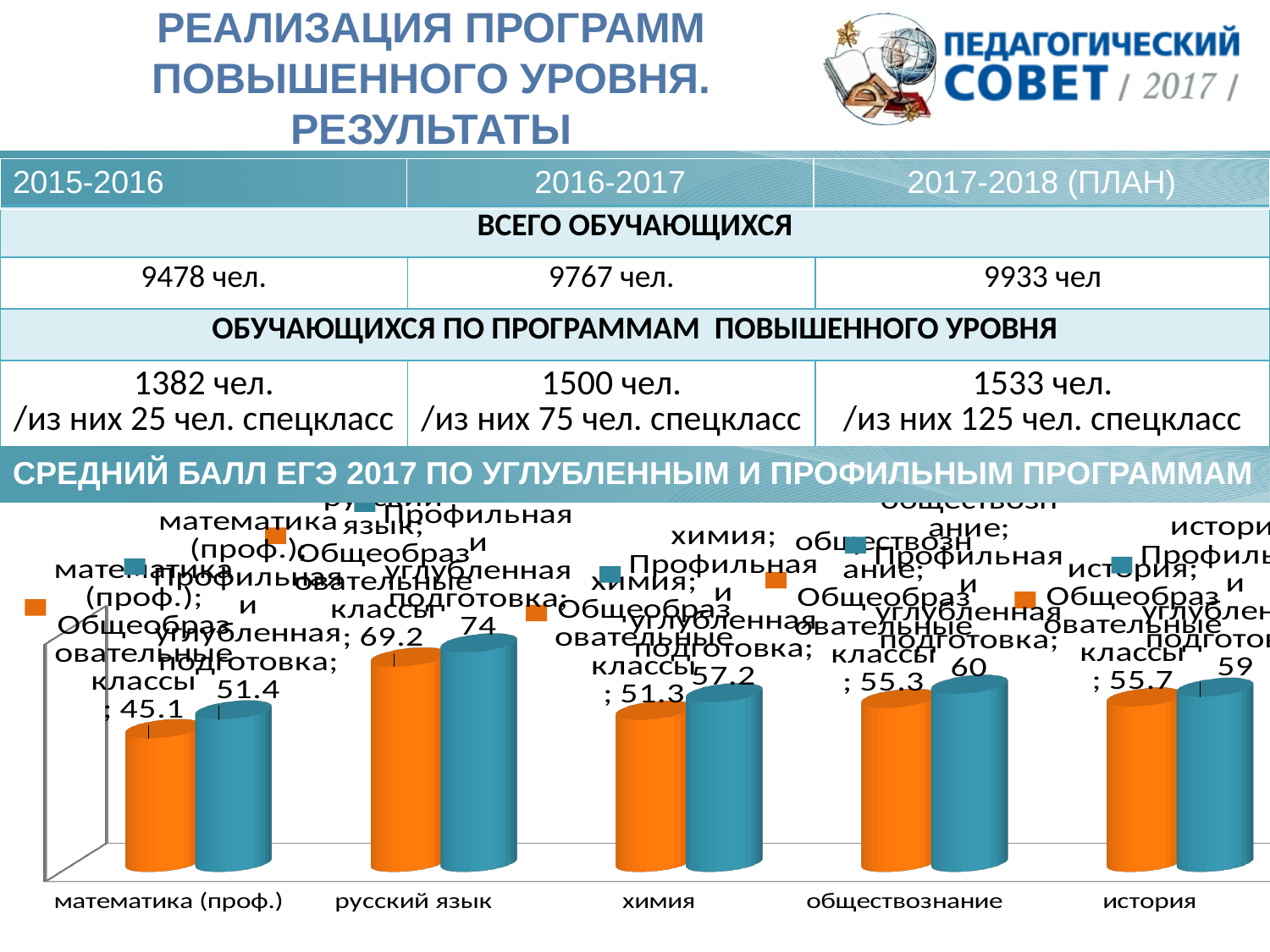
Which subject has the highest value for Профильная и углубленная подготовка? русский язык Which subject has the lowest value for Общеобразовательные классы? математика (проф.) How many series does the chart show? 2 How many subjects are shown on the x axis of the chart? 5 What is the difference between Профильная и углубленная подготовка and Общеобразовательные классы in математика (проф.)? 6.3 What is the value for Профильная и углубленная подготовка in обществознание? 60 What is the value for Общеобразовательные классы in математика (проф.)? 45.1 What is the value for Профильная и углубленная подготовка in русский язык? 74 What kind of chart is shown on the slide? bar chart What is the value for Общеобразовательные классы in история? 55.7 Which is larger in химия: Общеобразовательные классы or Профильная и углубленная подготовка? Профильная и углубленная подготовка What is the value for Общеобразовательные классы in химия? 51.3